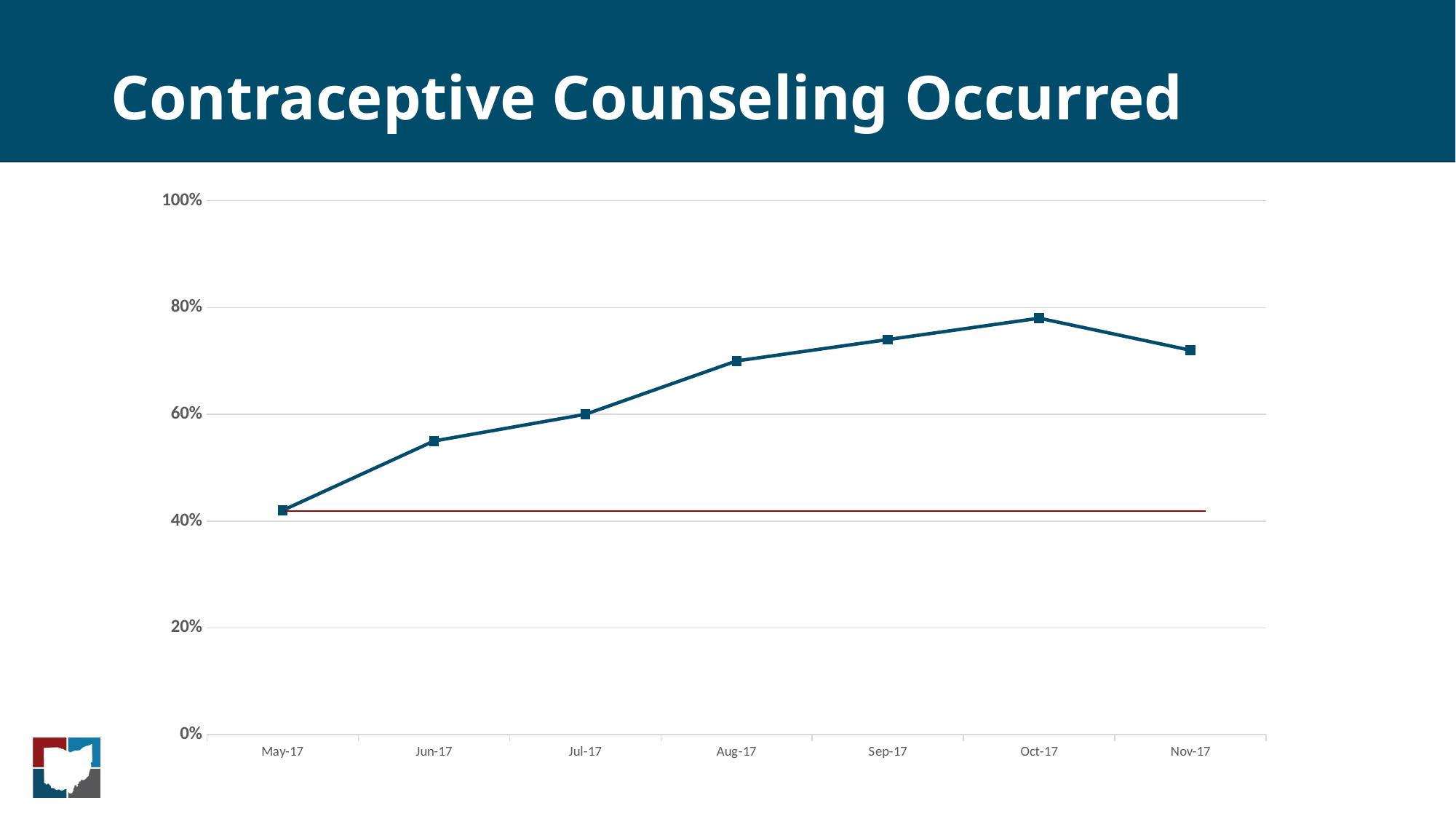
Which is larger, the value for Jun-17 or the value for Aug-17? Aug-17 How many months are plotted along the x axis? 7 Do the values generally rise or fall from May-17 to Oct-17? rise Which is larger, the value for Sep-17 or the value for Nov-17? Sep-17 Is the value for May-17 greater or less than 60%? less What kind of chart is shown on the slide? line chart What is the title of the slide containing the chart? Contraceptive Counseling Occurred Which month has the lowest value? May-17 Is the value for Oct-17 greater or less than 80%? less Which month has the highest value? Oct-17 Is the value for Jun-17 greater or less than 40%? greater